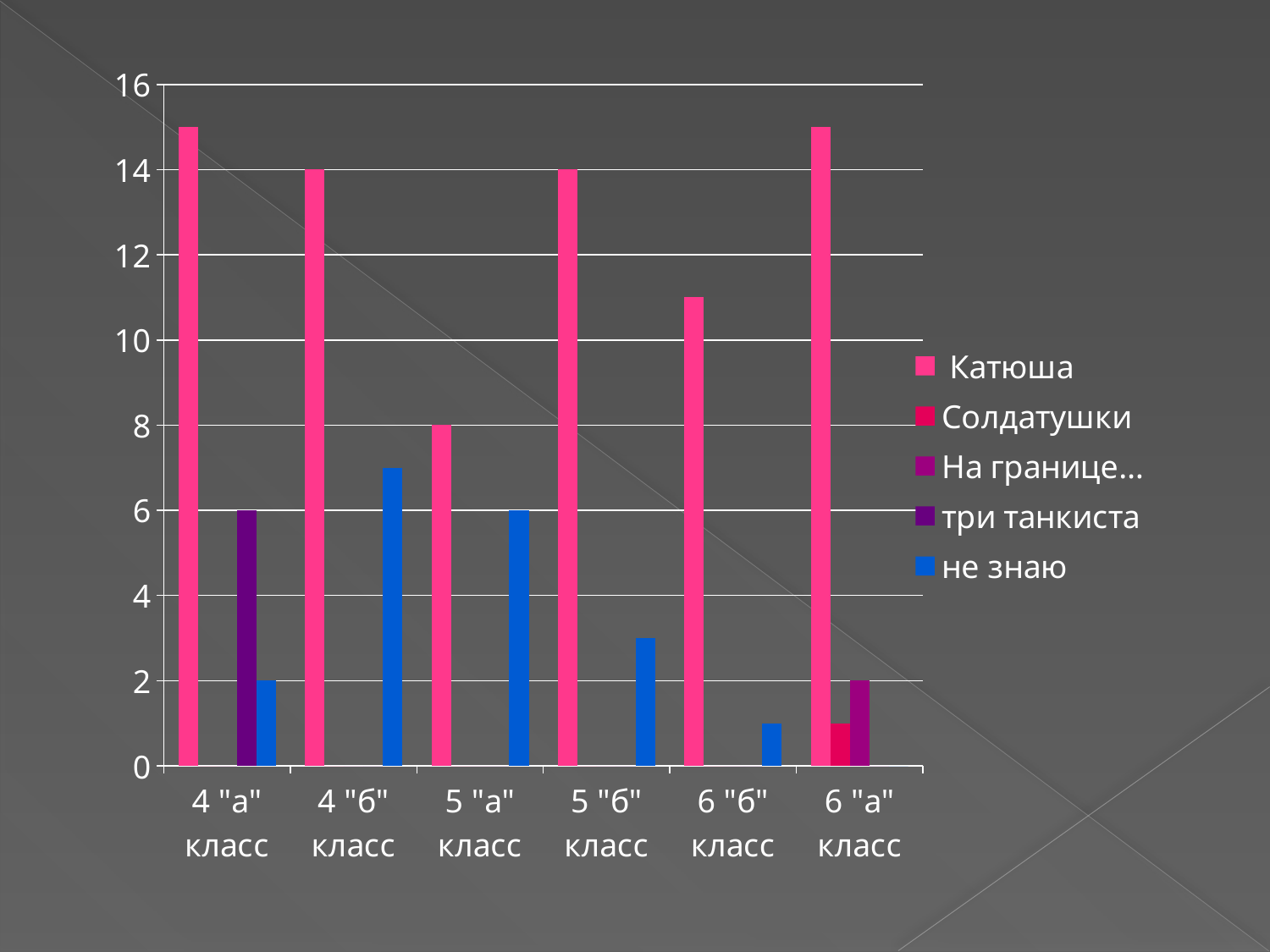
Which is larger in 4 "б" класс: the value for Катюша or the value for не знаю? Катюша What is the difference between the Катюша values for 4 "б" класс and 5 "а" класс? 6 What is the value for три танкиста in 4 "а" класс? 6 Is the value for не знаю in 5 "б" класс greater or less than 4? less What kind of chart is shown on the slide? bar chart How many series does the legend list? 5 What is the value for Катюша in 5 "а" класс? 8 How many classes (categories) are shown on the x axis? 6 What is the value for Катюша in 4 "б" класс? 14 Is the value for Катюша in 6 "б" класс greater or less than 10? greater Which class has the lowest value for Катюша? 5 "а" класс What is the value for не знаю in 5 "а" класс? 6